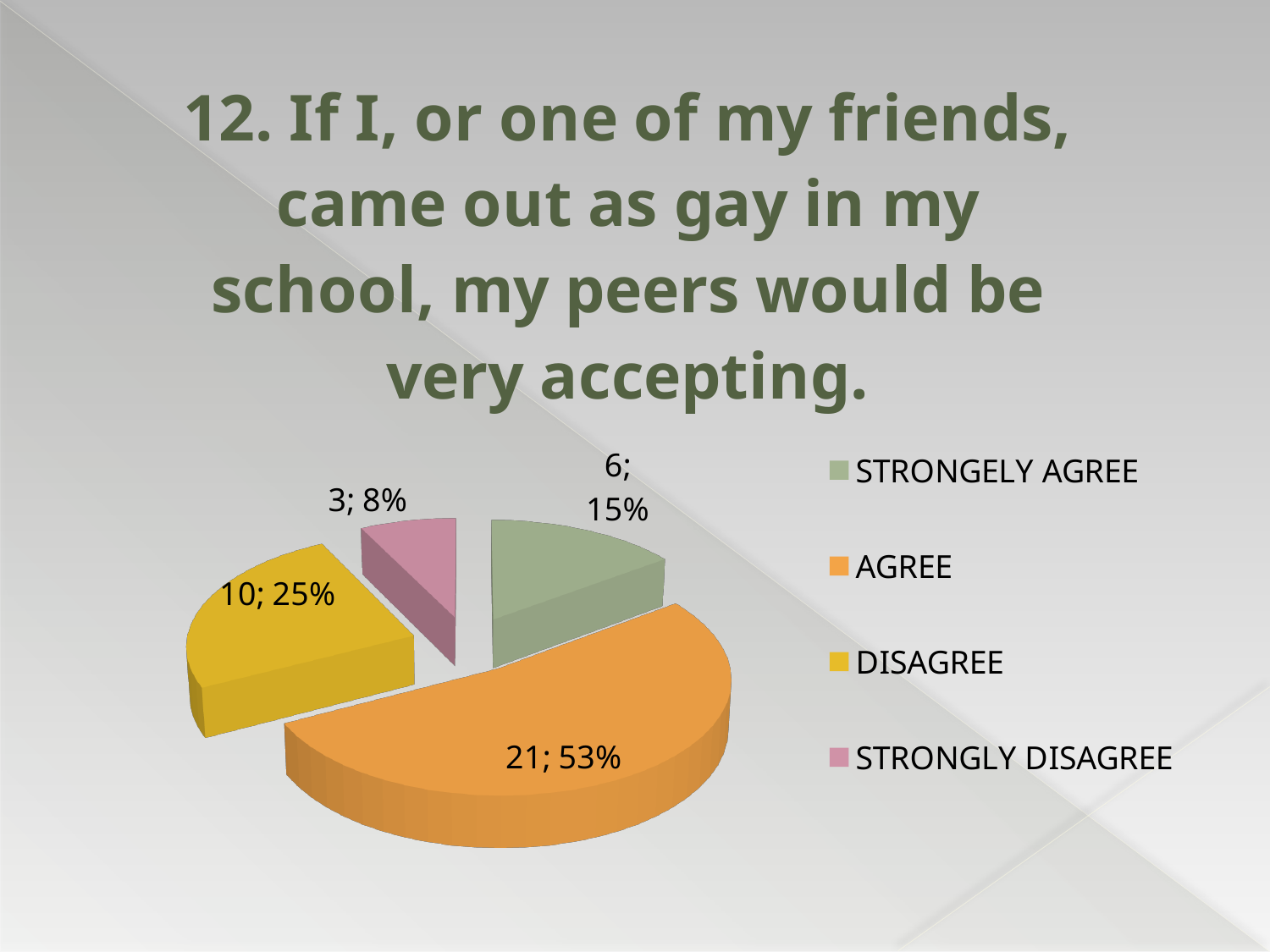
How many categories does the legend list? 4 What is the total of all the counts shown on the pie chart? 40 What kind of chart is shown on the slide? pie chart Which category has the largest slice? AGREE What percentage share does the DISAGREE slice have? 25% What is the count for STRONGELY AGREE? 6 Which is larger, the count for STRONGELY AGREE or the count for DISAGREE? DISAGREE What is the difference between the counts for AGREE and DISAGREE? 11 What colour is the AGREE slice? orange Which category has the smallest slice? STRONGLY DISAGREE What percentage share does the STRONGLY DISAGREE slice have? 8% What is the count for AGREE? 21